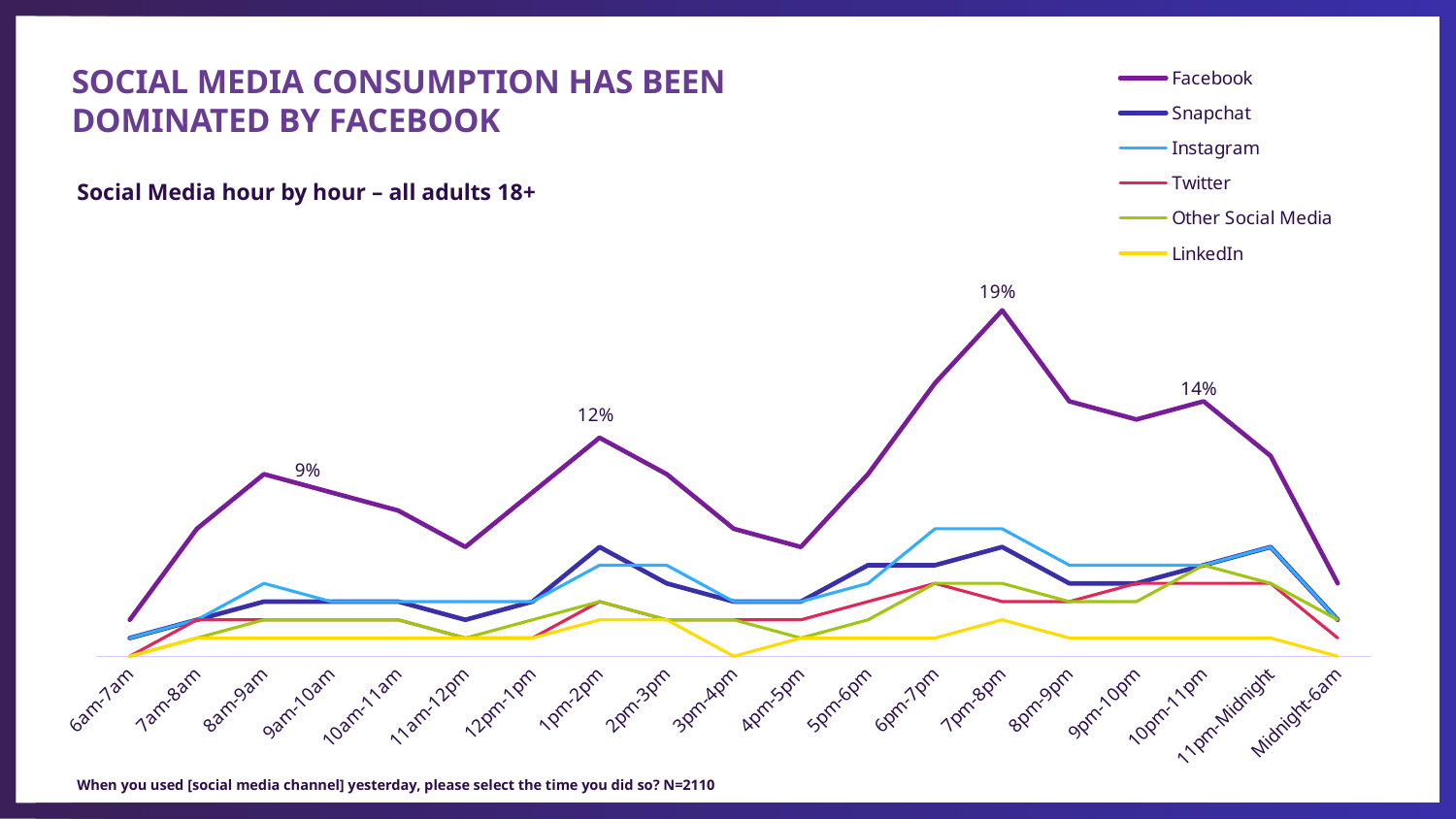
In which time slot is the Facebook value lowest? 6am-7am Which series is listed first in the legend? Facebook What is the Facebook value for 7pm-8pm? 19% How many series does the legend list? 6 In which time slot does Facebook reach its highest value? 7pm-8pm What is the Facebook value for 10pm-11pm? 14% What is the Facebook value for 1pm-2pm? 12% How many time-slot categories are shown on the x axis? 19 What kind of chart is shown on the slide? Line chart What is the difference between the Facebook values for 7pm-8pm and 1pm-2pm? 7 percentage points Which is larger for Facebook: the value at 10pm-11pm or the value at 8am-9am? 10pm-11pm